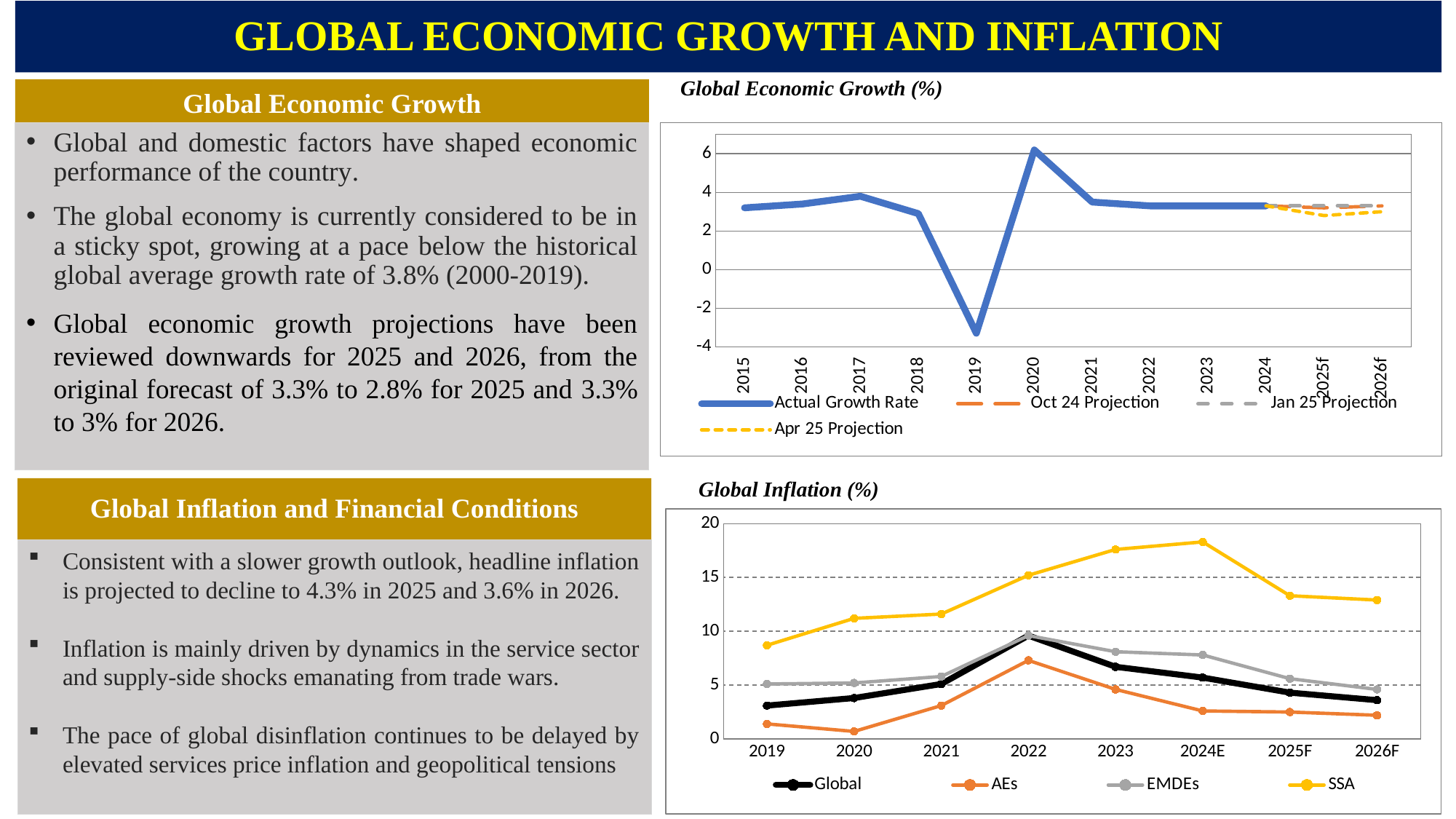
In the 'Global Economic Growth (%)' chart, which year has the lowest actual growth rate? 2019 In the 'Global Economic Growth (%)' chart, is the actual growth rate for 2020 greater or less than 4? greater In the 'Global Inflation (%)' chart, does the SSA line rise or fall from 2024E to 2026F? fall How many years are shown on the x axis of the 'Global Economic Growth (%)' chart? 12 How many years are shown on the x axis of the 'Global Inflation (%)' chart? 8 How many series does the legend of the 'Global Inflation (%)' chart list? 4 In the 'Global Inflation (%)' chart, is the SSA value for 2024E greater or less than 15? greater What kind of chart is the 'Global Economic Growth (%)' chart? line chart In the 'Global Economic Growth (%)' chart, which year has the highest actual growth rate? 2020 In the 'Global Economic Growth (%)' chart, is the actual growth rate for 2019 greater or less than 0? less In the 'Global Inflation (%)' chart, which series has the highest value in 2024E? SSA How many series does the legend of the 'Global Economic Growth (%)' chart list? 4